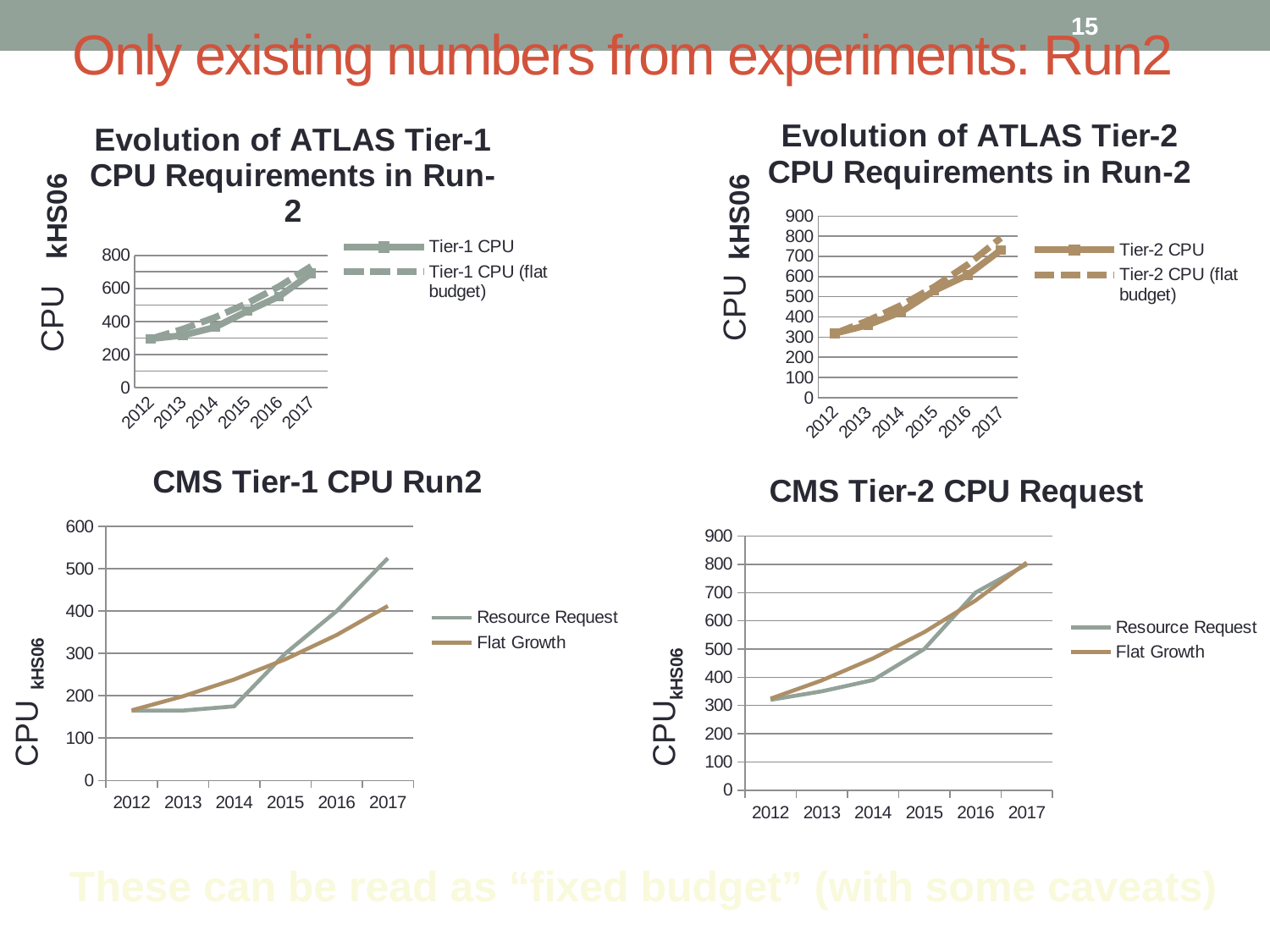
What kind of chart is the "CMS Tier-1 CPU Run2" chart? line chart How many years are shown on the x axis of the "CMS Tier-2 CPU Request" chart? 6 In the "CMS Tier-2 CPU Request" chart, which series has the larger value in 2014, Resource Request or Flat Growth? Flat Growth How many series does the legend of the "Evolution of ATLAS Tier-1 CPU Requirements in Run-2" chart list? 2 In the "CMS Tier-1 CPU Run2" chart, is the Resource Request value for 2012 greater or less than 200? less In the "Evolution of ATLAS Tier-1 CPU Requirements in Run-2" chart, is the Tier-1 CPU value for 2012 greater or less than 400? less In the "CMS Tier-2 CPU Request" chart, is the Resource Request value for 2012 greater or less than 400? less What are the two legend entries of the "CMS Tier-2 CPU Request" chart? Resource Request and Flat Growth In the "Evolution of ATLAS Tier-2 CPU Requirements in Run-2" chart, do the Tier-2 CPU values rise or fall from 2012 to 2017? rise What is the title of the chart in the top-right of the slide? Evolution of ATLAS Tier-2 CPU Requirements in Run-2 In the "CMS Tier-1 CPU Run2" chart, which series has the larger value in 2017, Resource Request or Flat Growth? Resource Request